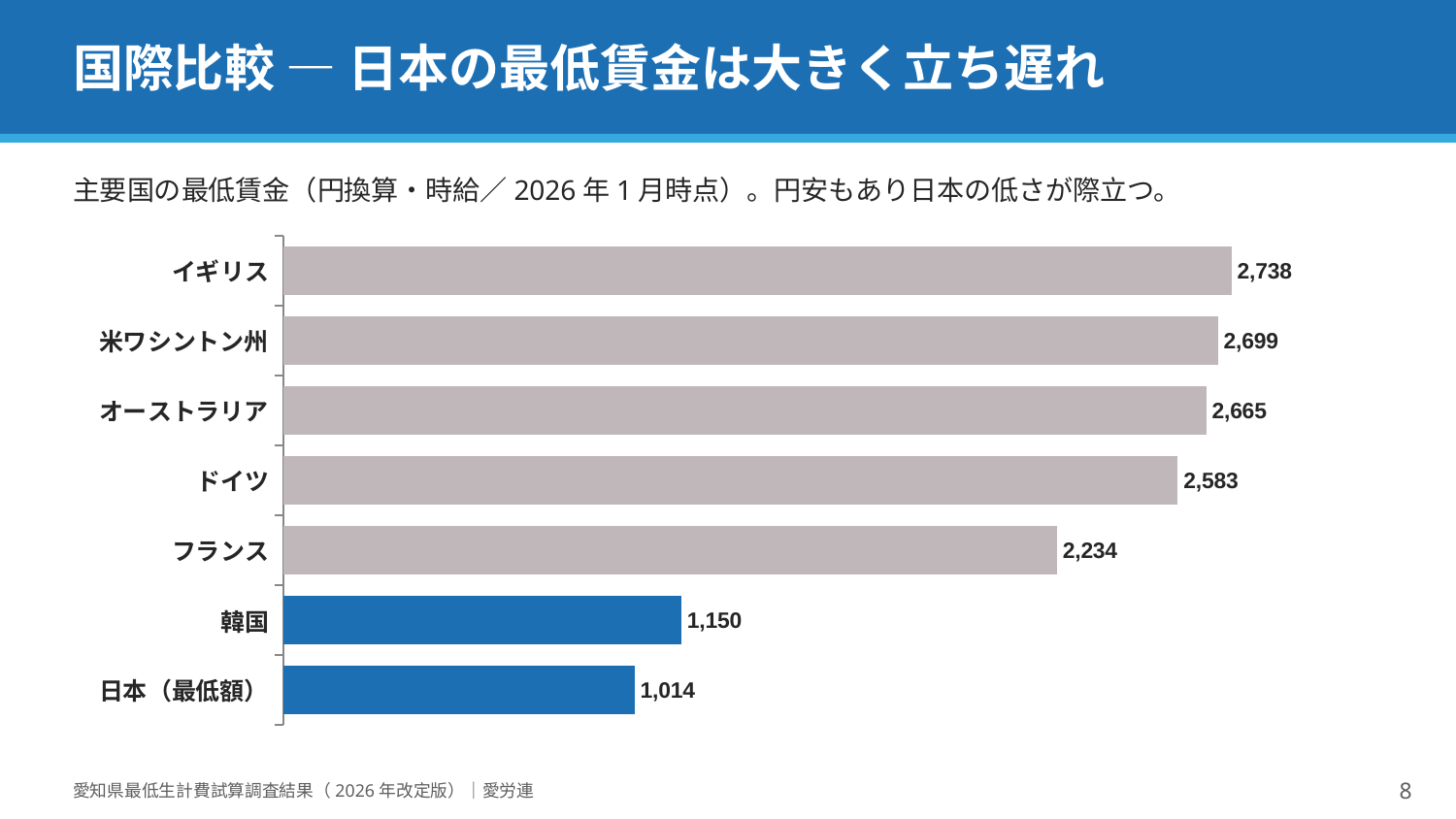
What is the value for 日本（最低額）? 1,014 What is the value for 韓国? 1,150 Which is larger, the value for ドイツ or the value for フランス? ドイツ What is the difference between the values for イギリス and 日本（最低額）? 1,724 Which categories are shown with blue bars instead of grey? 韓国 and 日本（最低額） How many categories are shown in the chart? 7 What is the value for イギリス? 2,738 What is the difference between the values for 韓国 and 日本（最低額）? 136 What kind of chart is shown on the slide? Bar chart What is the value for フランス? 2,234 Which category has the lowest value? 日本（最低額） Which category has the highest value? イギリス